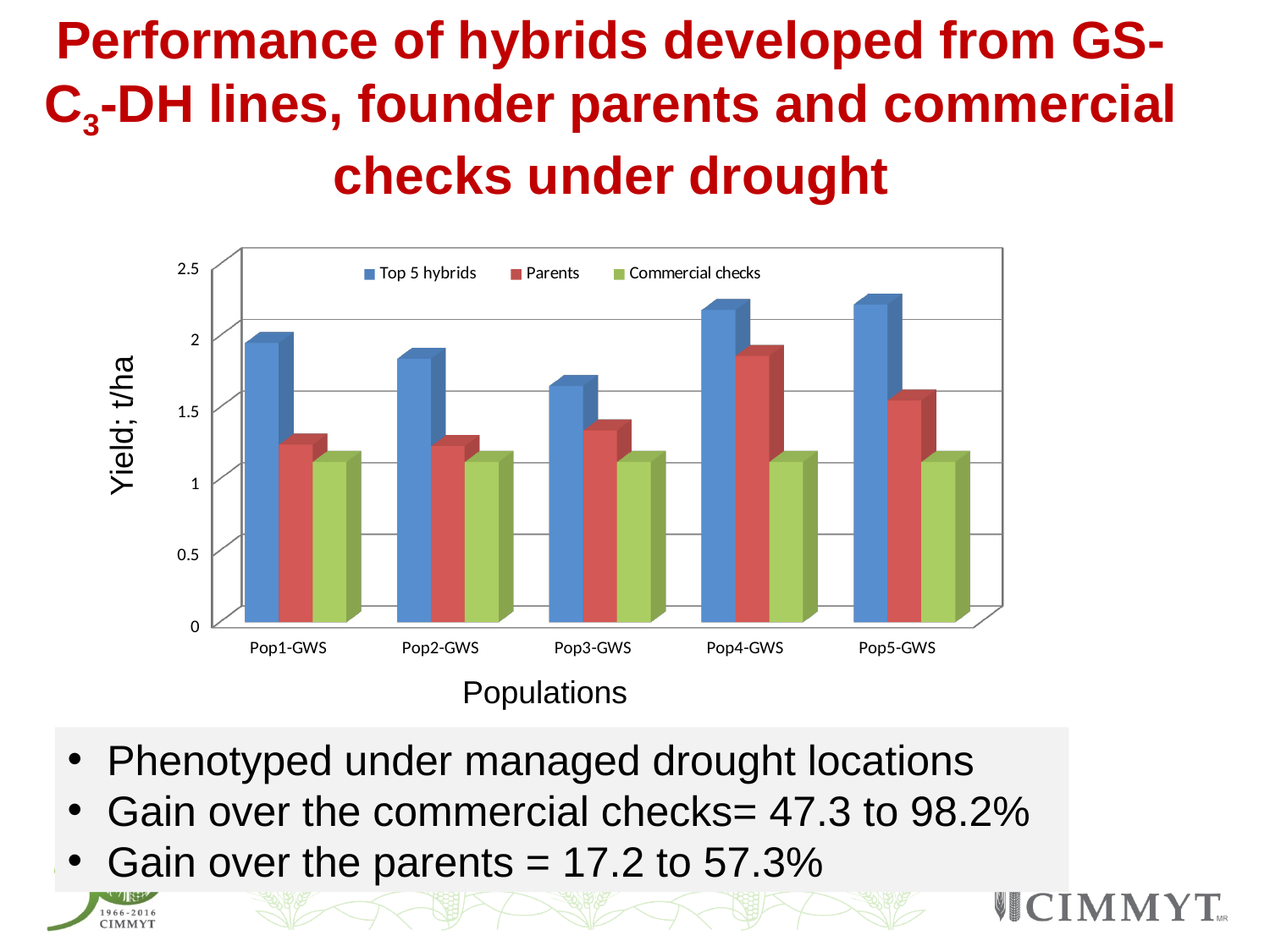
How many series does the chart legend list? 3 Which is larger: the Parents value for Pop4-GWS or for Pop2-GWS? Pop4-GWS What kind of chart is shown on the slide? bar chart Is the Top 5 hybrids value for Pop4-GWS greater or less than 2? greater What is the label of the vertical axis of the chart? Yield; t/ha Is the Parents value for Pop1-GWS greater or less than 1.5? less How many populations are shown on the x axis of the chart? 5 Which population has the lowest value for Top 5 hybrids? Pop3-GWS What is the label of the horizontal axis of the chart? Populations Which population has the highest value for Parents? Pop4-GWS Is the Top 5 hybrids value for Pop3-GWS greater or less than 1.5? greater Which is larger: the Top 5 hybrids value for Pop1-GWS or for Pop3-GWS? Pop1-GWS